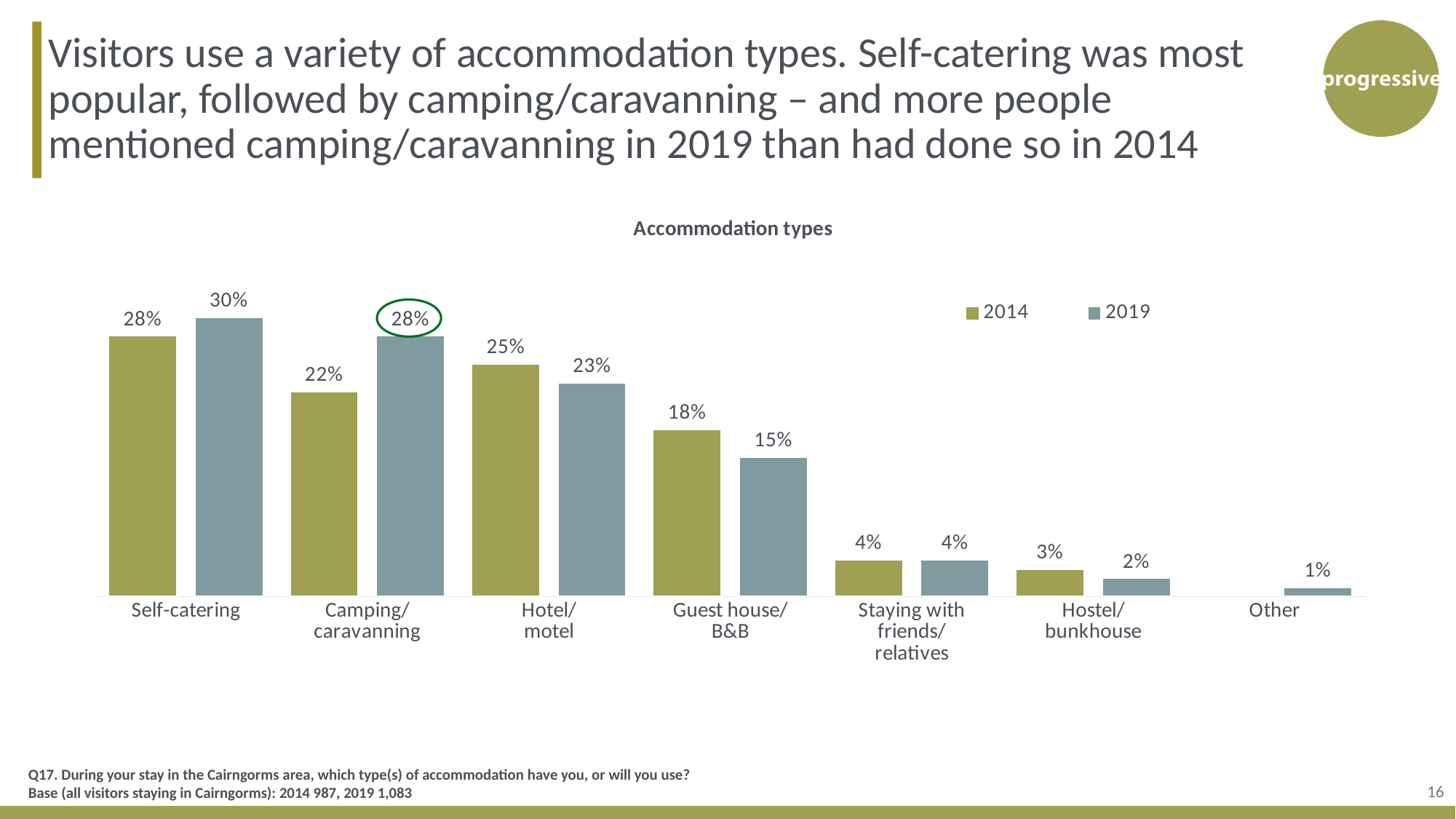
Which is larger for Hotel/motel, the 2014 value or the 2019 value? 2014 What is the 2014 value for Camping/caravanning? 22% Which accommodation type has the lowest 2014 value among those with a 2014 bar? Hostel/bunkhouse What is the 2014 value for Hostel/bunkhouse? 3% What kind of chart is shown on the slide? Bar chart How many accommodation type categories are shown on the x axis? 7 What is the 2019 value for Self-catering? 30% Which accommodation type has the highest 2019 value? Self-catering What is the title of the chart? Accommodation types How many series does the legend list? 2 What is the difference between the 2019 and 2014 values for Camping/caravanning? 6 percentage points What is the 2019 value for Guest house/B&B? 15%